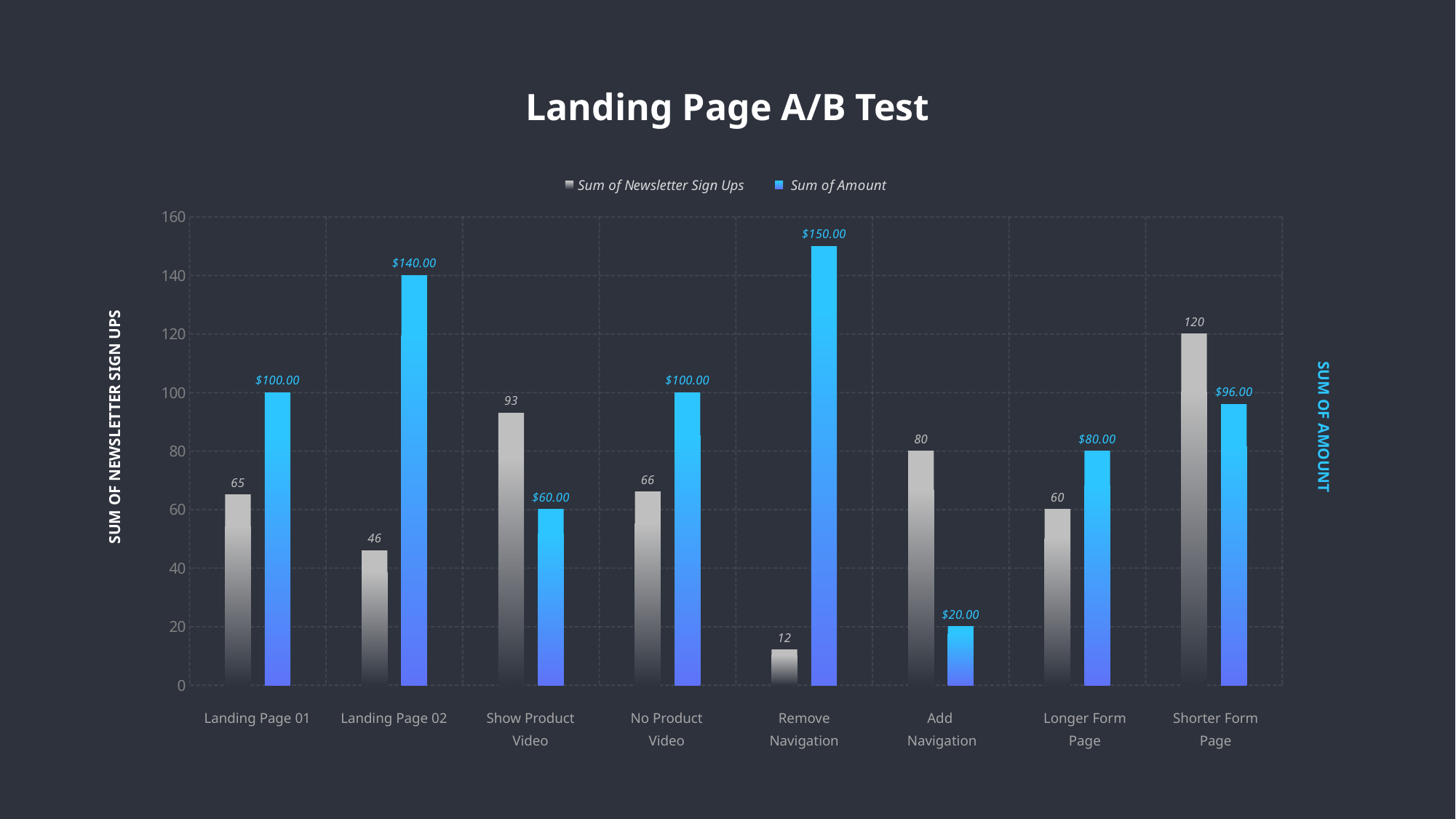
Which category has the lowest Sum of Newsletter Sign Ups? Remove Navigation What is the title of the chart? Landing Page A/B Test Which category has the highest Sum of Newsletter Sign Ups? Shorter Form Page How many categories are shown on the x axis? 8 What is the Sum of Amount for Shorter Form Page? $96.00 What is the Sum of Amount for Remove Navigation? $150.00 How many series does the legend list? 2 What kind of chart is shown on the slide? Bar chart Which category has the lowest Sum of Amount? Add Navigation Which has a larger Sum of Amount, Landing Page 02 or No Product Video? Landing Page 02 What is the difference in Sum of Newsletter Sign Ups between Shorter Form Page and Longer Form Page? 60 What is the Sum of Newsletter Sign Ups for Show Product Video? 93